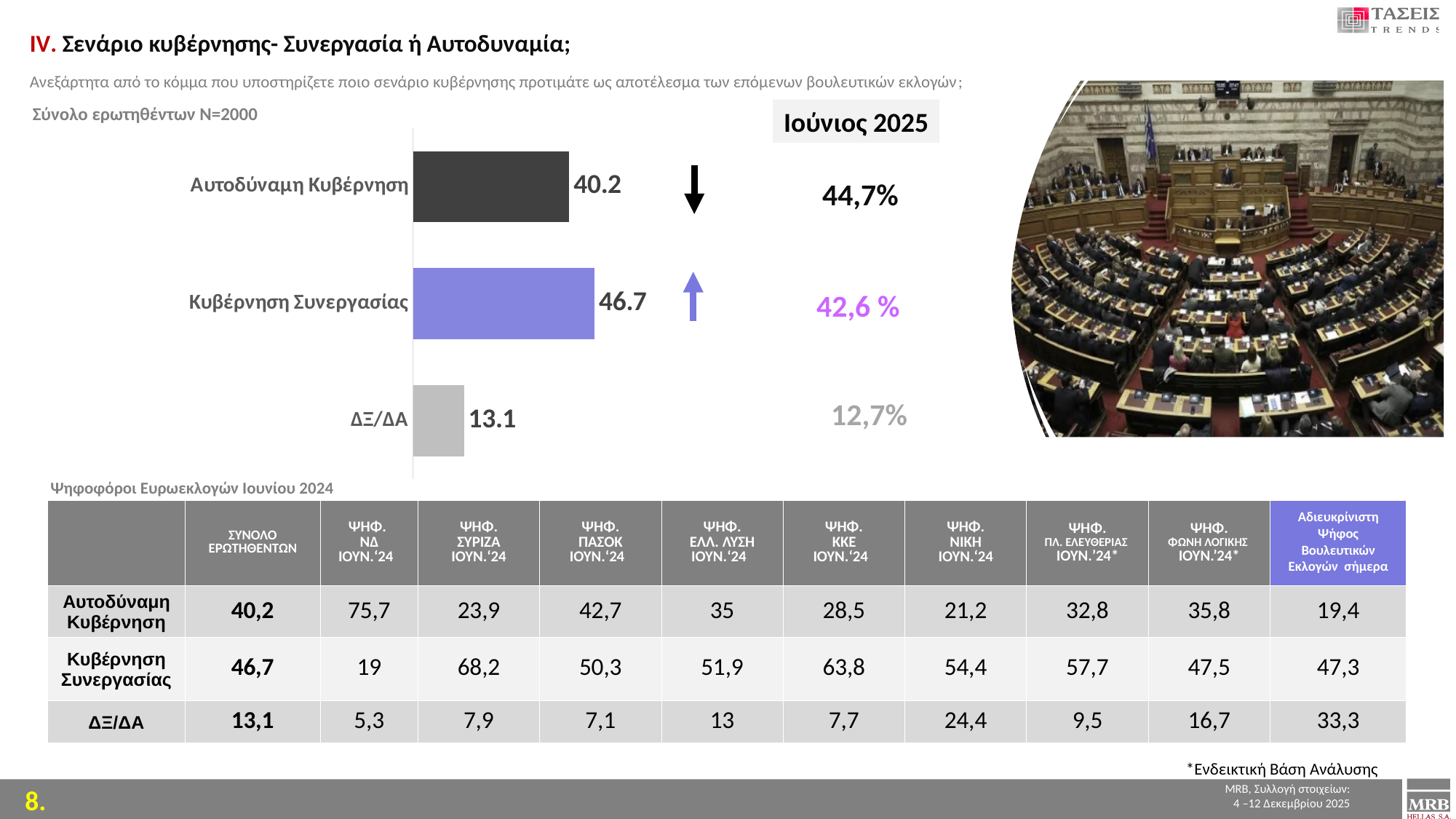
How many categories does the bar chart show? 3 What value does the bar chart show for Κυβέρνηση Συνεργασίας? 46.7 Which category has the highest value in the bar chart? Κυβέρνηση Συνεργασίας What kind of chart is shown on the slide? Bar chart Which category has the lowest value in the bar chart? ΔΞ/ΔΑ What is the total of the three values shown in the bar chart? 100 What value does the bar chart show for Αυτοδύναμη Κυβέρνηση? 40.2 Which is larger in the bar chart: Αυτοδύναμη Κυβέρνηση or ΔΞ/ΔΑ? Αυτοδύναμη Κυβέρνηση What colour is the bar for Κυβέρνηση Συνεργασίας? Blue/purple What value does the bar chart show for ΔΞ/ΔΑ? 13.1 What is the difference between the values for Κυβέρνηση Συνεργασίας and Αυτοδύναμη Κυβέρνηση in the bar chart? 6.5 What June 2025 (Ιούνιος 2025) value is shown next to the Αυτοδύναμη Κυβέρνηση bar? 44,7%